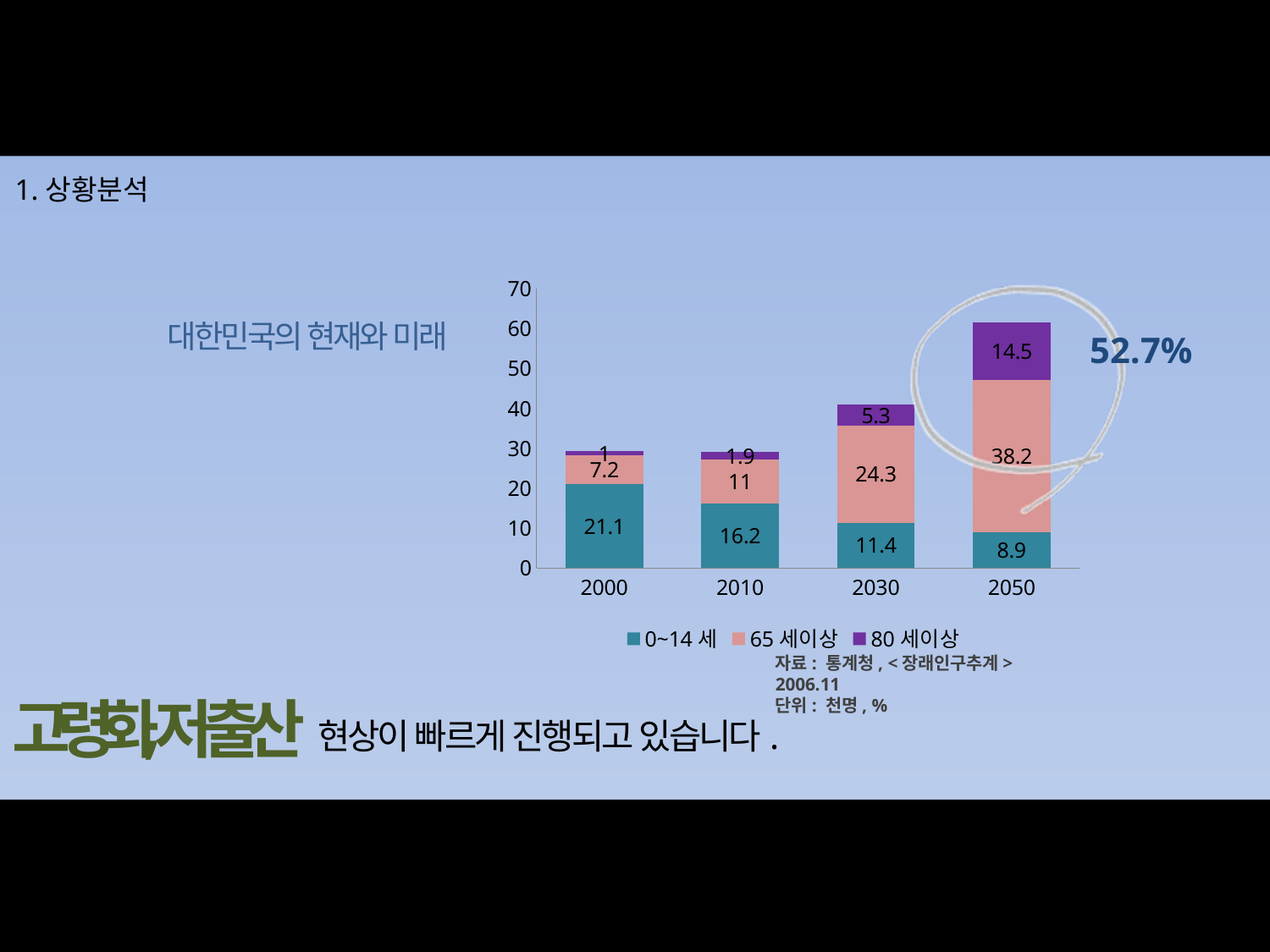
What is the value for 65 세이상 in 2050? 38.2 What is the difference between the 65 세이상 values for 2050 and 2030? 13.9 What is the value for 80 세이상 in 2030? 5.3 Which year has the highest value for 0~14 세? 2000 What is the value for 0~14 세 in 2000? 21.1 What is the total of the stacked bar for 2050? 61.6 What is the value for 65 세이상 in 2010? 11 How many series does the legend list? 3 How many years are shown on the x axis? 4 Which year has the lowest value for 80 세이상? 2000 What kind of chart is shown? Stacked bar chart Which is larger: the 0~14 세 value in 2010 or the 65 세이상 value in 2010? 0~14 세 in 2010